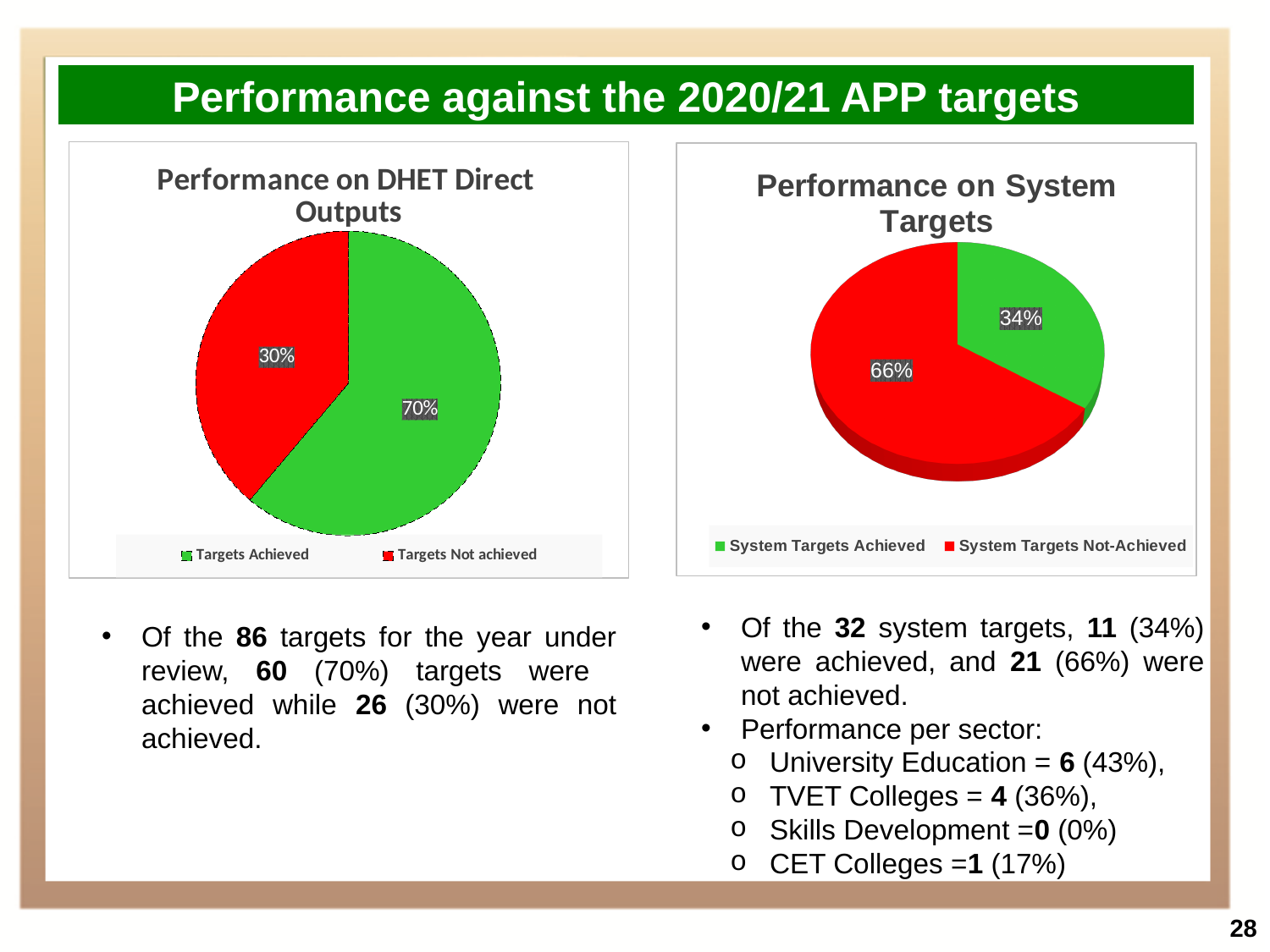
In the 'Performance on System Targets' chart, what share of the pie is System Targets Achieved? 34% In the 'Performance on DHET Direct Outputs' chart, what colour is the Targets Not achieved slice? Red In the 'Performance on System Targets' chart, what is the difference in percentage points between System Targets Not-Achieved and System Targets Achieved? 32 percentage points How many slices does the 'Performance on System Targets' chart have? 2 In the 'Performance on DHET Direct Outputs' chart, what share of the pie is Targets Not achieved? 30% In the 'Performance on DHET Direct Outputs' chart, what share of the pie is Targets Achieved? 70% In the 'Performance on System Targets' chart, which slice is the smallest? System Targets Achieved What type of chart is the 'Performance on DHET Direct Outputs' chart? Pie chart In the 'Performance on DHET Direct Outputs' chart, what is the difference in percentage points between Targets Achieved and Targets Not achieved? 40 percentage points In the 'Performance on DHET Direct Outputs' chart, which slice is the largest? Targets Achieved In the 'Performance on System Targets' chart, which is larger: System Targets Achieved or System Targets Not-Achieved? System Targets Not-Achieved